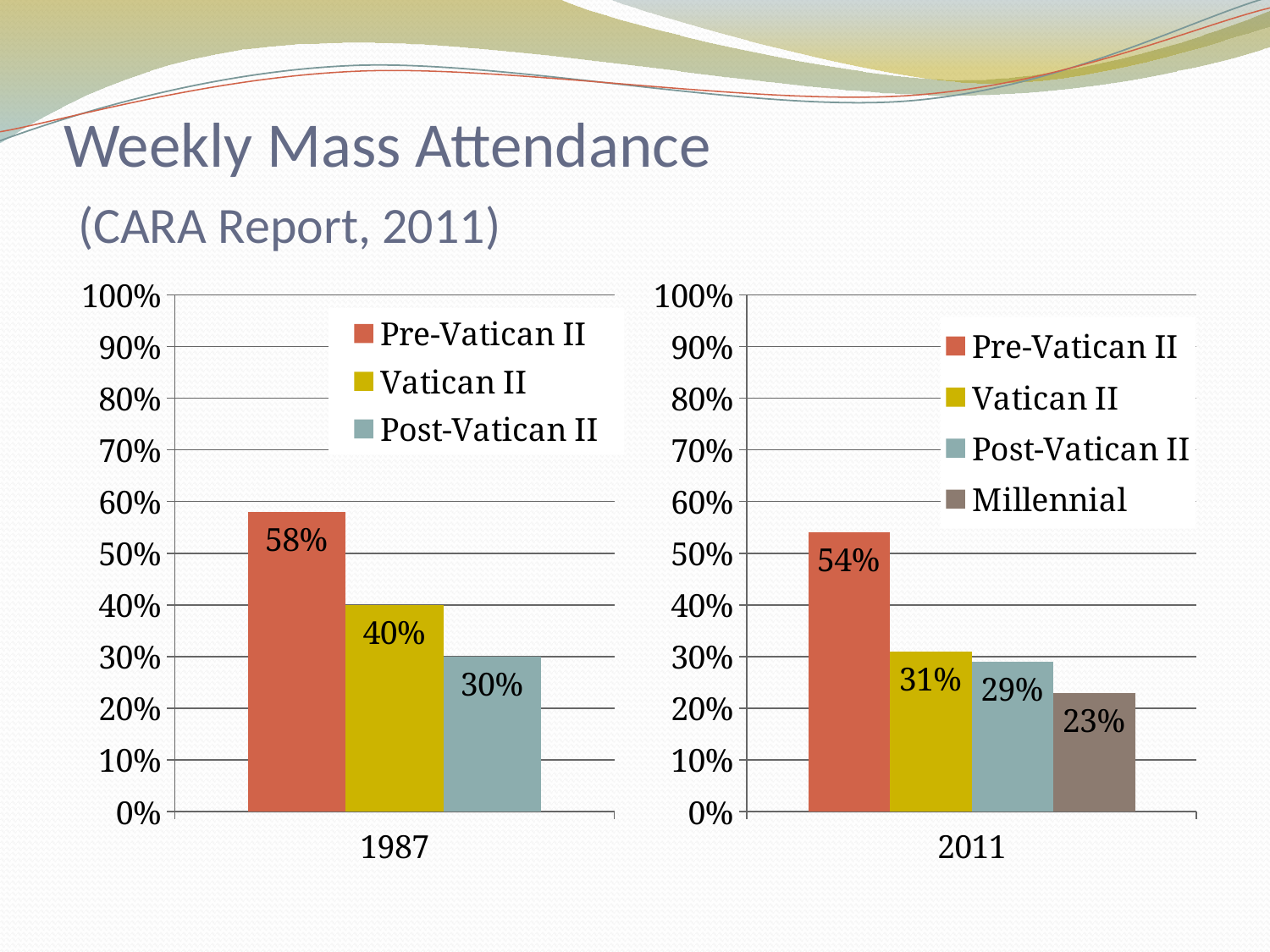
In the right chart (2011), what is the value for Millennial? 23% In the right chart (2011), what is the difference between the Pre-Vatican II and Millennial values? 31% In the right chart (2011), what is the value for Vatican II? 31% In the right chart (2011), what colour is the Millennial bar? Brown In the left chart (1987), which series has the lowest value? Post-Vatican II In the right chart (2011), which is larger, Vatican II or Post-Vatican II? Vatican II In the left chart (1987), what is the difference between the Pre-Vatican II and Vatican II values? 18% How many series does the legend of the right chart (2011) list? 4 How many series does the legend of the left chart (1987) list? 3 What kind of chart is the left chart (1987)? Bar chart In the right chart (2011), which series has the highest value? Pre-Vatican II In the left chart (1987), what is the value for Pre-Vatican II? 58%